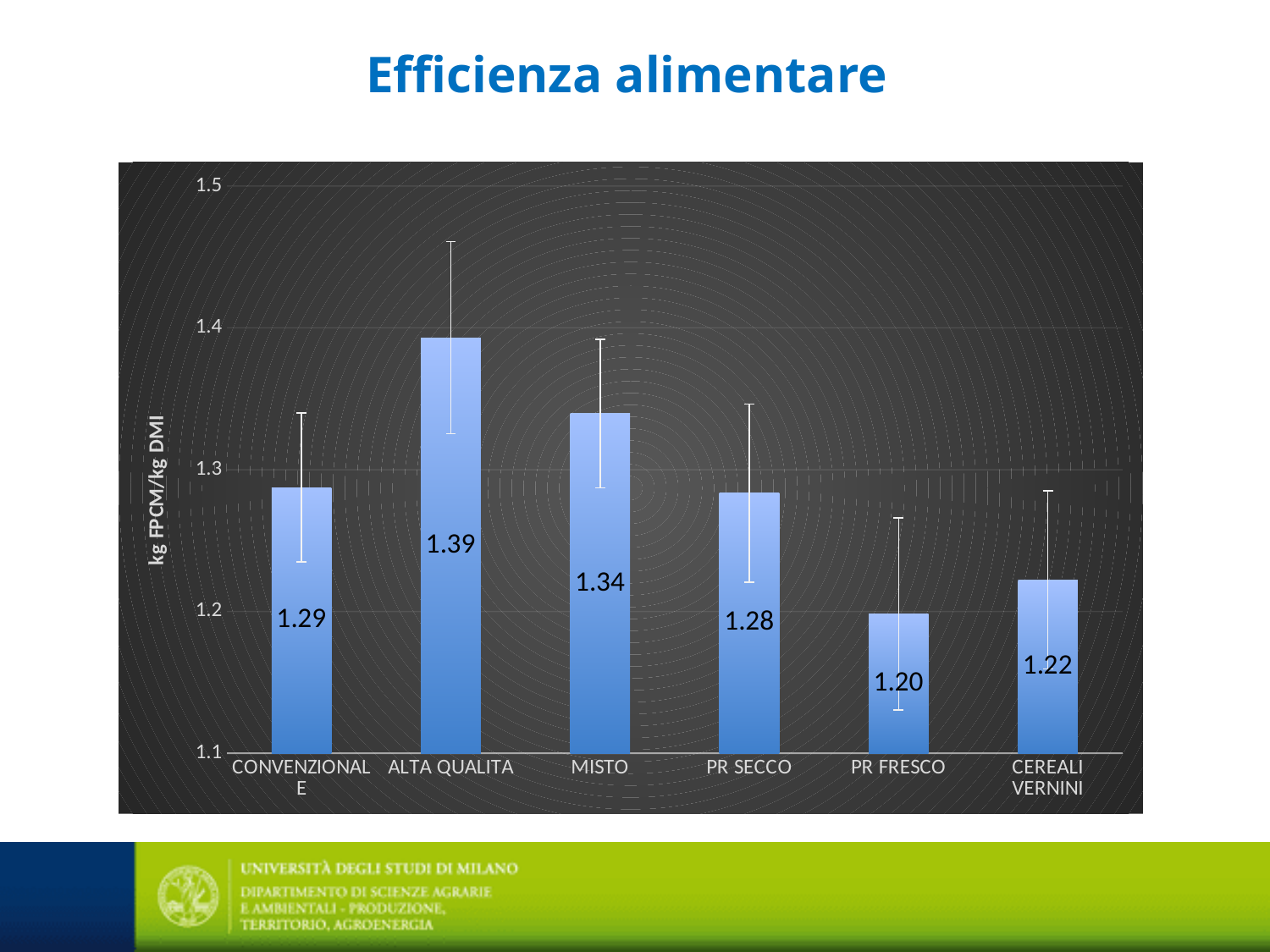
Is the value for MISTO greater or less than 1.3? greater What is the label of the vertical axis? kg FPCM/kg DMI What is the value for ALTA QUALITA? 1.39 What is the value for CEREALI VERNINI? 1.22 What is the value for PR FRESCO? 1.20 What is the value for MISTO? 1.34 What kind of chart is shown on the slide? bar chart Which category has the lowest value? PR FRESCO What is the difference between the values for ALTA QUALITA and PR FRESCO? 0.19 Which category has the highest value? ALTA QUALITA Which is larger, the value for CONVENZIONALE or the value for PR SECCO? CONVENZIONALE How many categories are shown on the x axis? 6